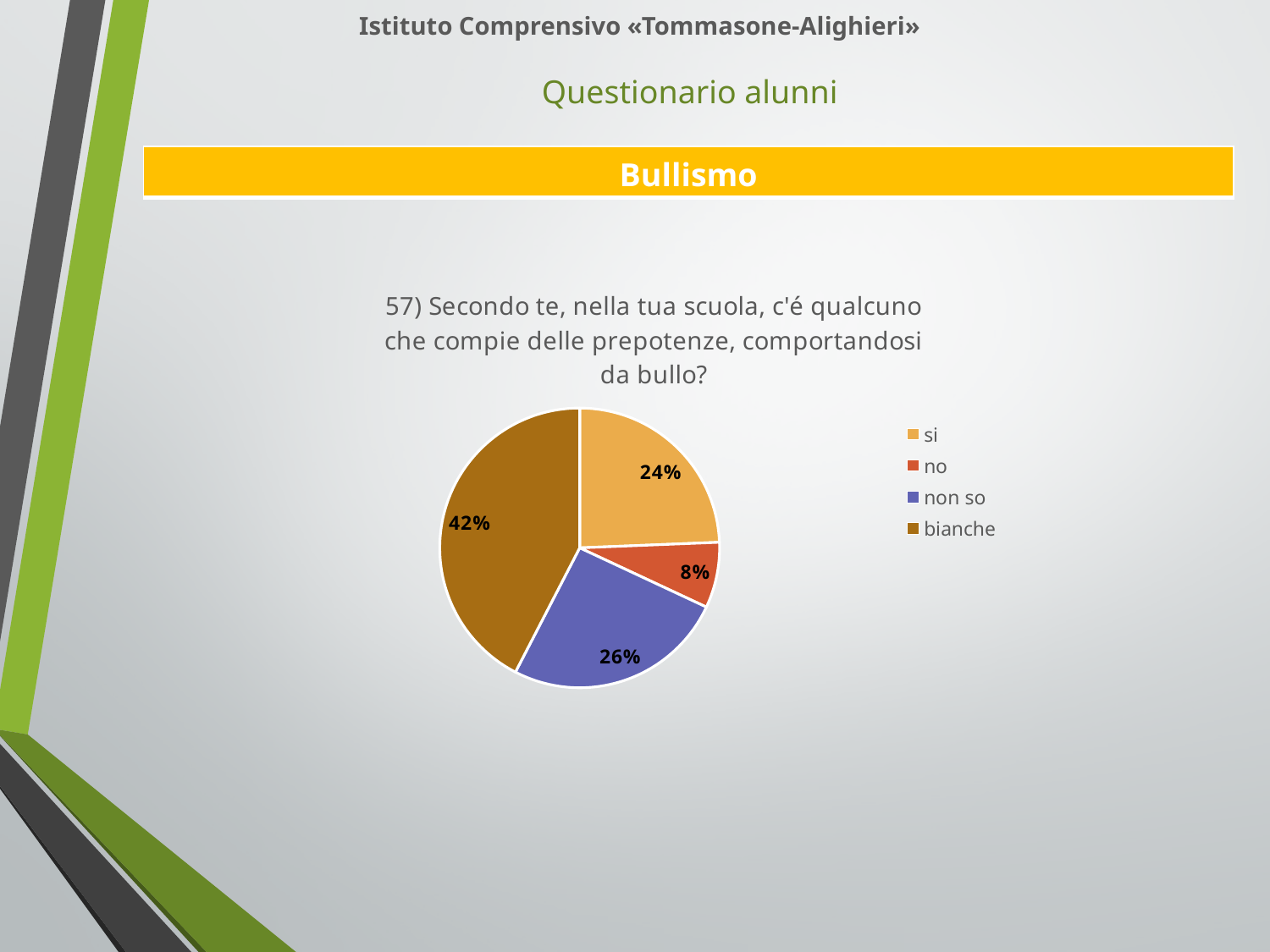
What is the difference in percentage points between "bianche" and "si"? 18 How many categories does the legend list? 4 What colour is the "non so" slice? blue What percentage of responses is "non so"? 26% What is the combined percentage of "si" and "no" responses? 32% What percentage of responses is "bianche"? 42% What percentage of responses is "si"? 24% What percentage of responses is "no"? 8% Which is larger, the share for "non so" or the share for "si"? non so What type of chart is shown on the slide? pie chart Which category has the largest share of the pie? bianche Which category has the smallest share of the pie? no